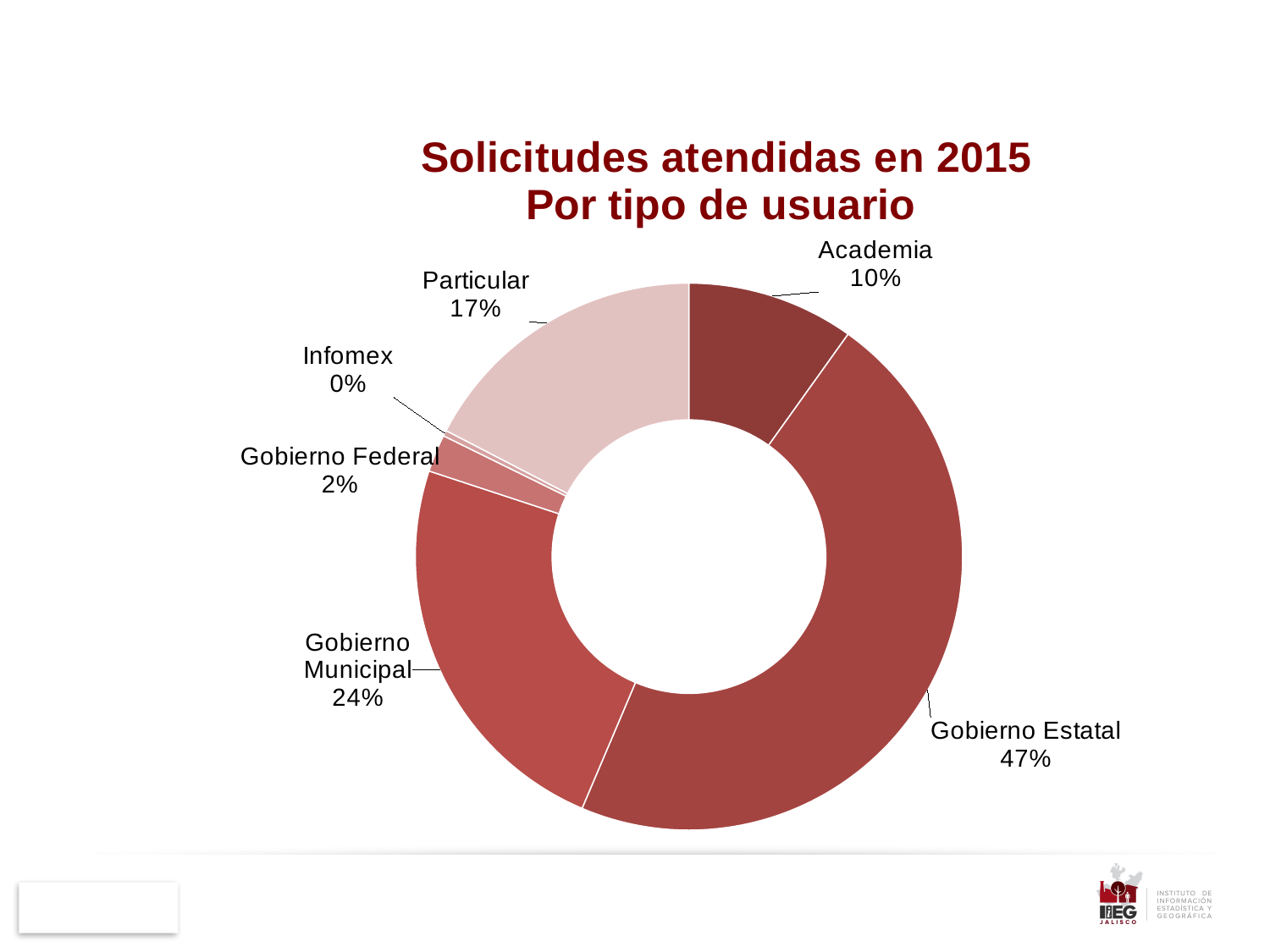
What is the value shown for Infomex? 0% What kind of chart is shown on the slide? Doughnut chart Which category has the smallest share? Infomex Which category has the largest share? Gobierno Estatal What share of the chart does Gobierno Estatal represent? 47% What is the title of the chart? Solicitudes atendidas en 2015 Por tipo de usuario What is the value shown for Particular? 17% What is the difference between the shares of Gobierno Estatal and Gobierno Municipal? 23% What is the value shown for Gobierno Municipal? 24% How many categories are shown in the chart? 6 Which is larger, the share for Particular or the share for Academia? Particular What is the value shown for Academia? 10%